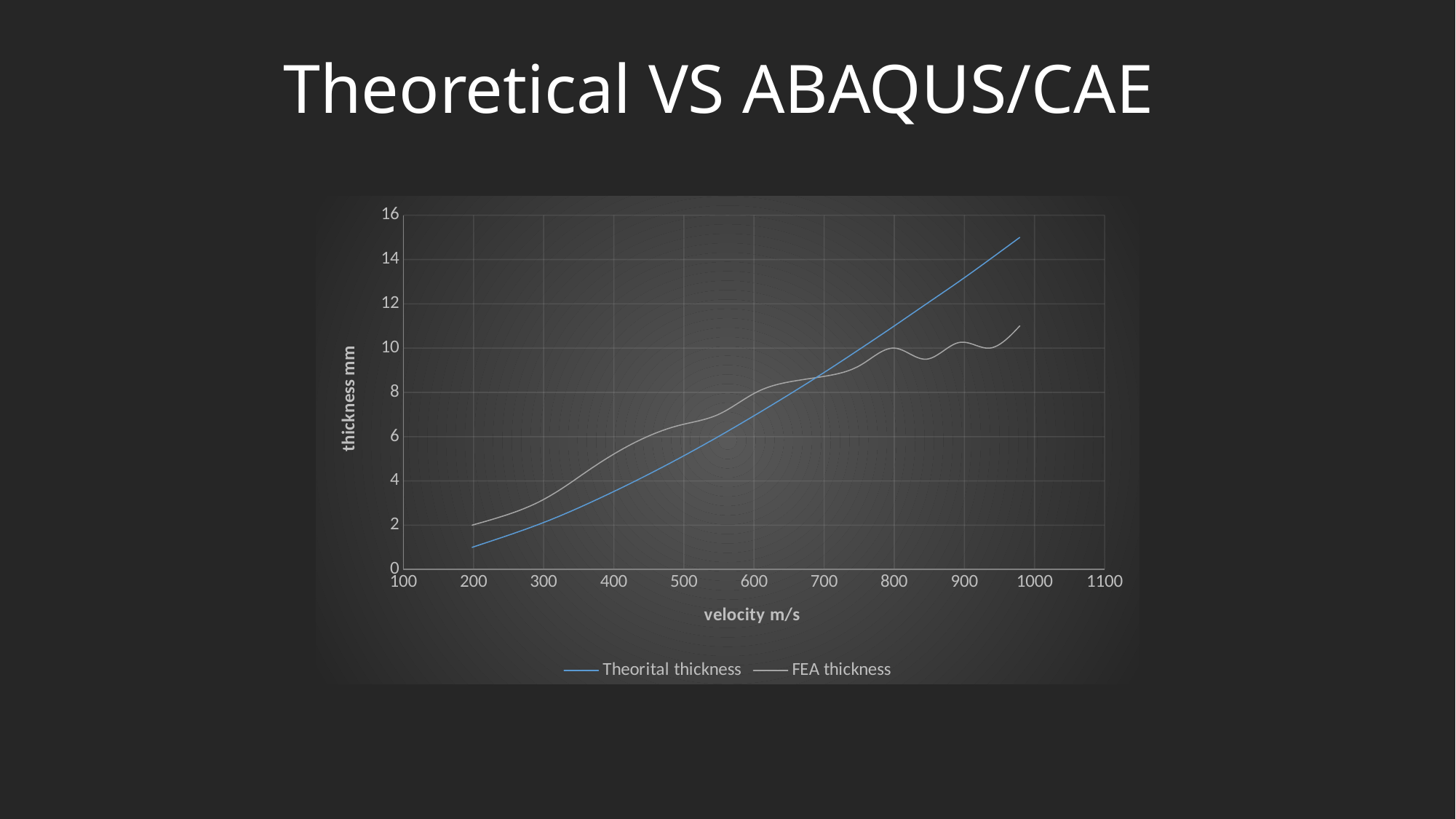
Does the FEA thickness line generally rise or fall as velocity increases from 200 to 1000 m/s? rise At a velocity of 900 m/s, which series has the higher thickness, Theoritical thickness or FEA thickness? Theoritical thickness How many series does the legend list? 2 Is the FEA thickness at 800 m/s greater or less than 8 mm? greater What is the title of the vertical axis? thickness mm At a velocity of 400 m/s, which series has the higher thickness, Theoritical thickness or FEA thickness? FEA thickness What kind of chart is shown on the slide? line chart Does the Theoritical thickness line rise or fall as velocity increases? rise Is the Theoritical thickness at 500 m/s greater or less than 6 mm? less What are the two series named in the legend? Theorital thickness and FEA thickness Which series reaches the highest thickness value on the chart? Theoritical thickness Is the Theoritical thickness at 900 m/s greater or less than 12 mm? greater